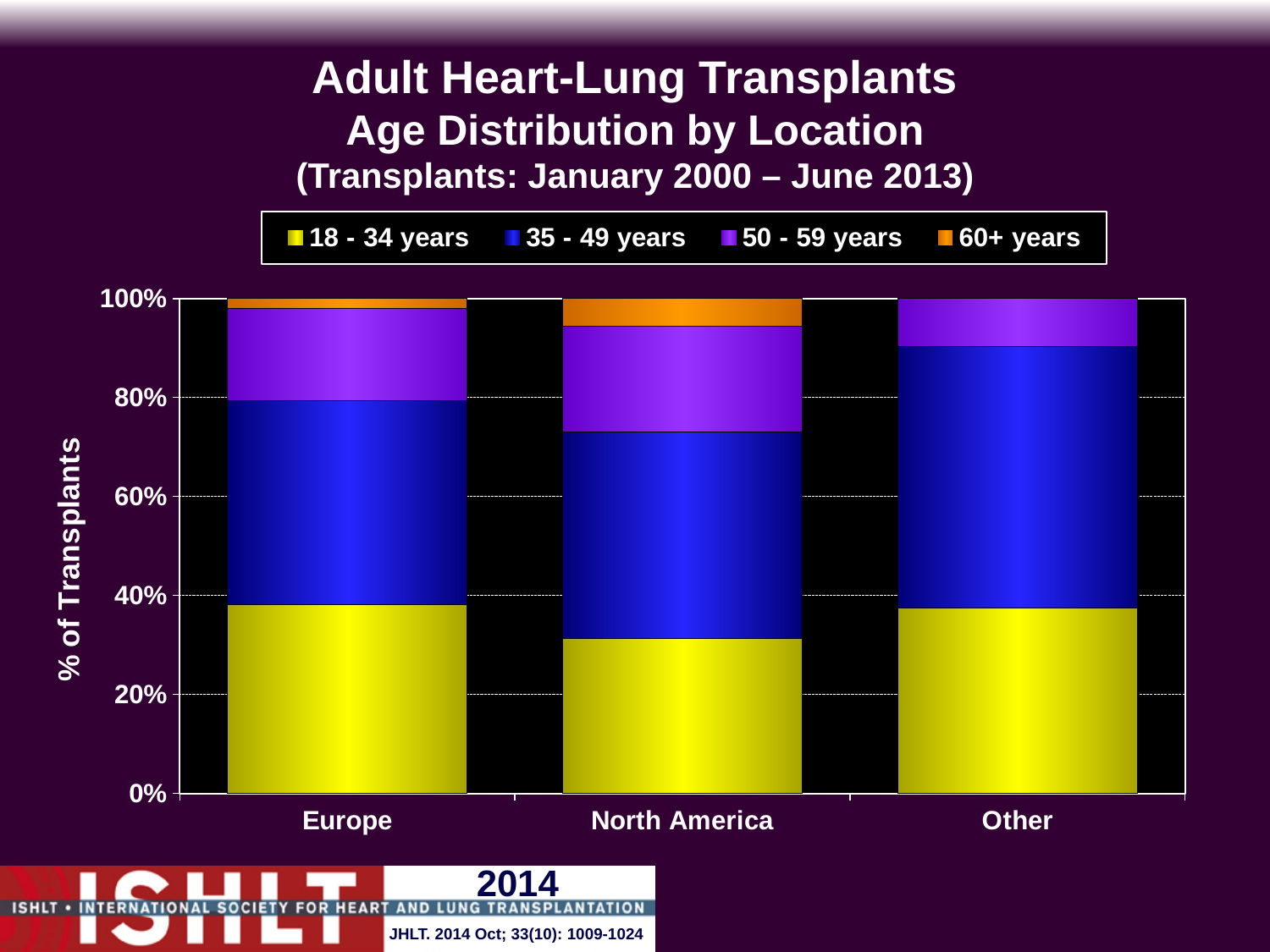
How many locations (categories) are shown on the x axis? 3 Which location has the largest 60+ years share? North America Is the 18 - 34 years share for North America greater or less than 40%? less Is the 18 - 34 years share for Europe greater or less than 40%? less Is the cumulative share of the 18 - 34 and 35 - 49 years groups for Other greater or less than 80%? greater What kind of chart is shown on the slide? Stacked bar chart Which has the larger 18 - 34 years share, Europe or North America? Europe What is the label on the y axis? % of Transplants Which location has the largest 35 - 49 years share? Other How many age groups does the legend list? 4